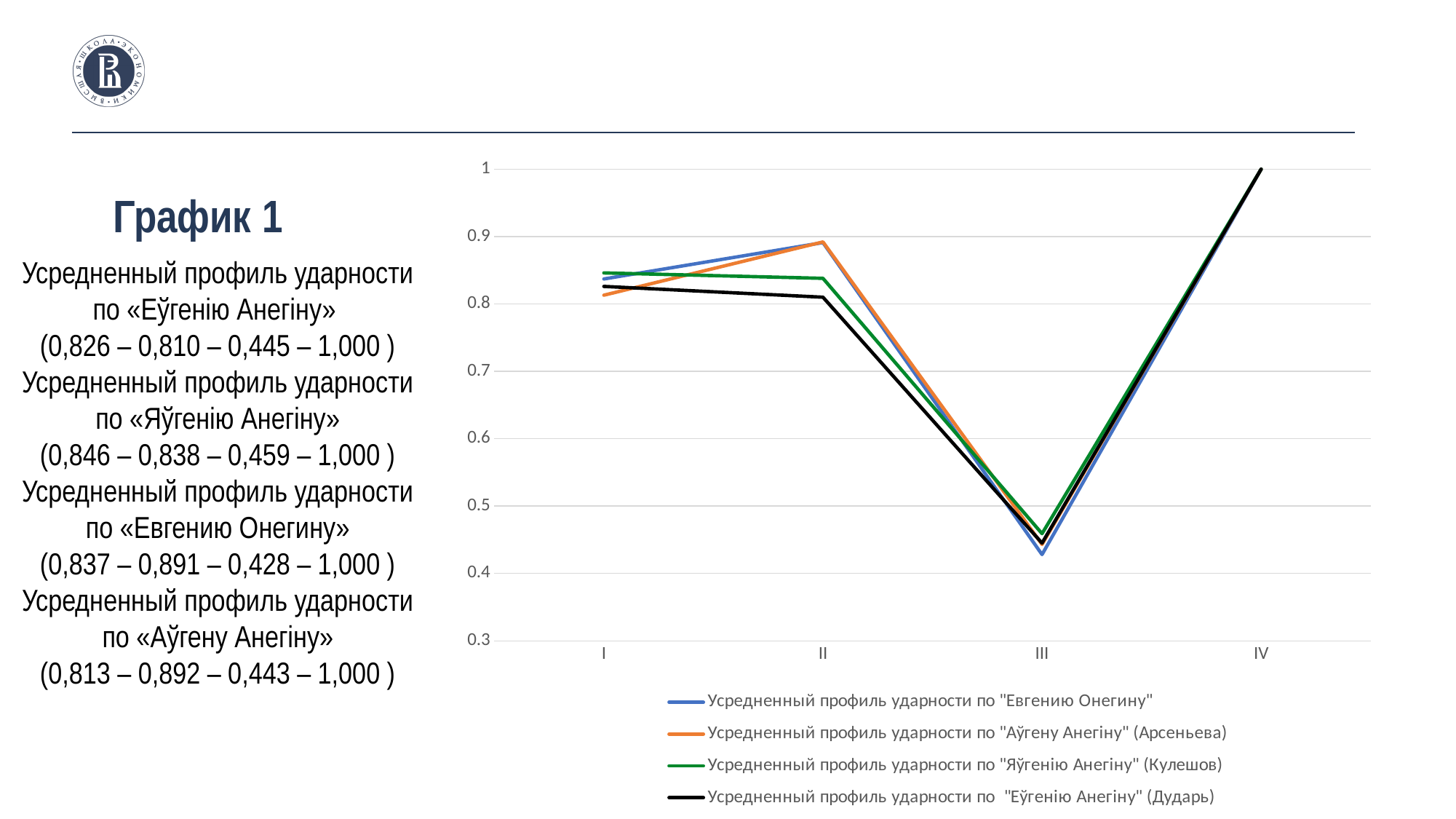
What is the value at position III for the series "Усредненный профиль ударности по «Евгению Онегину»"? 0,428 Do the values rise or fall from position II to position III? fall What is the difference between the values at positions II and III for the series "Яўгенію Анегіну"? 0,379 At which x-axis position do all series reach their highest value? IV How many points are plotted along the x axis for each series? 4 At position II, which series has the larger value: "Евгению Онегину" or "Еўгенію Анегіну"? Евгению Онегину Is the value at position III for the series "Яўгенію Анегіну" greater or less than 0.5? less What colour is the line for "Усредненный профиль ударности по «Евгению Онегину»"? blue How many series does the legend list? 4 At which x-axis position do all series reach their lowest value? III What is the value at position II for the series "Усредненный профиль ударности по «Аўгену Анегіну»"? 0,892 What kind of chart is shown on the slide? line chart